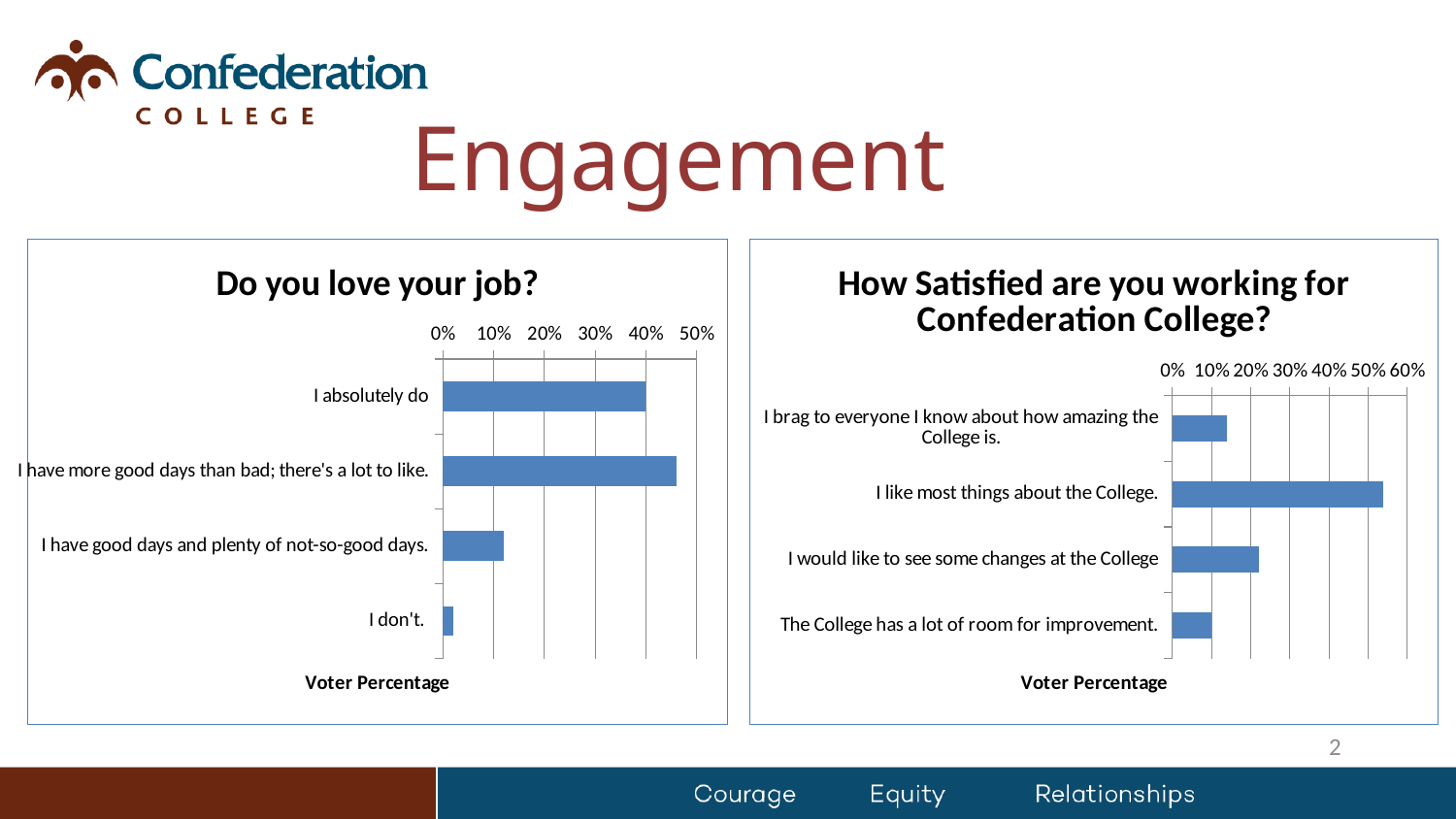
In the "Do you love your job?" chart, is the value for "I have more good days than bad; there's a lot to like." greater or less than 40%? greater What is the axis label shown below the bars in the "How Satisfied are you working for Confederation College?" chart? Voter Percentage In the "How Satisfied are you working for Confederation College?" chart, which category has the highest value? I like most things about the College. In the "How Satisfied are you working for Confederation College?" chart, which is larger: "I would like to see some changes at the College" or "The College has a lot of room for improvement."? I would like to see some changes at the College How many categories are shown in the "Do you love your job?" chart? 4 What kind of chart is the "Do you love your job?" chart? bar chart In the "Do you love your job?" chart, which category has the highest value? I have more good days than bad; there's a lot to like. How many categories are shown in the "How Satisfied are you working for Confederation College?" chart? 4 In the "How Satisfied are you working for Confederation College?" chart, is the value for "I like most things about the College." greater or less than 40%? greater In the "Do you love your job?" chart, which category has the lowest value? I don't. In the "Do you love your job?" chart, which is larger: "I absolutely do" or "I don't."? I absolutely do In the "Do you love your job?" chart, is the value for "I have good days and plenty of not-so-good days." greater or less than 20%? less